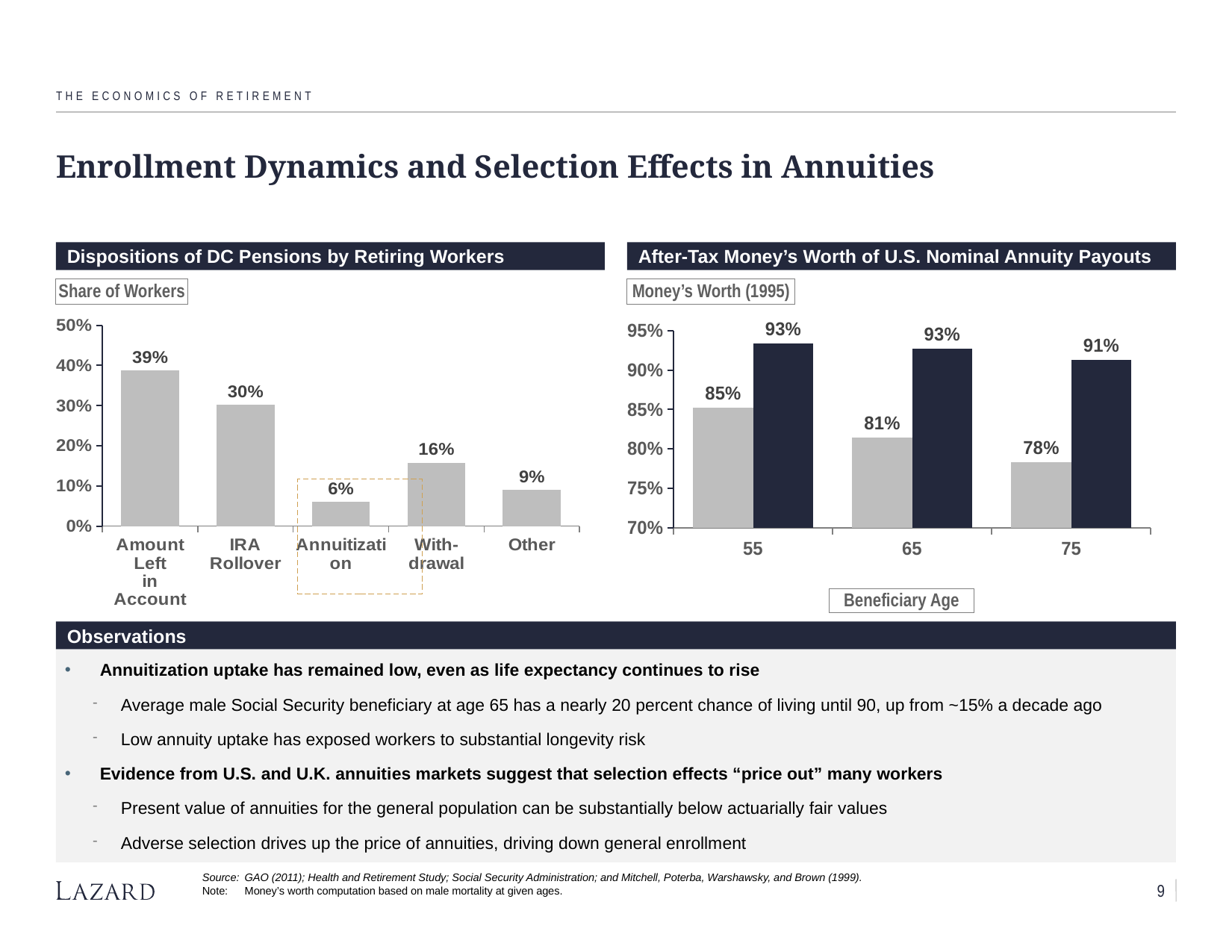
In the 'Dispositions of DC Pensions by Retiring Workers' chart, what share of workers chose Annuitization? 6% In the 'After-Tax Money's Worth of U.S. Nominal Annuity Payouts' chart, what is the value of the dark navy bar at beneficiary age 75? 91% In the 'Dispositions of DC Pensions by Retiring Workers' chart, which category has the lowest share of workers? Annuitization In the 'Dispositions of DC Pensions by Retiring Workers' chart, what share of workers chose IRA Rollover? 30% In the 'After-Tax Money's Worth of U.S. Nominal Annuity Payouts' chart, what is the value of the light grey bar at beneficiary age 65? 81% In the 'Dispositions of DC Pensions by Retiring Workers' chart, which category has the highest share of workers? Amount Left in Account In the 'After-Tax Money's Worth of U.S. Nominal Annuity Payouts' chart, what is the difference between the dark navy bar and the light grey bar at beneficiary age 55? 8% In the 'After-Tax Money's Worth of U.S. Nominal Annuity Payouts' chart, do the light grey bars rise or fall as beneficiary age increases from 55 to 75? Fall In the 'After-Tax Money's Worth of U.S. Nominal Annuity Payouts' chart, what is the label shown below the x axis? Beneficiary Age In the 'Dispositions of DC Pensions by Retiring Workers' chart, how many categories are shown? 5 In the 'Dispositions of DC Pensions by Retiring Workers' chart, what is the difference between the shares for Amount Left in Account and Withdrawal? 23% What type of chart is 'Dispositions of DC Pensions by Retiring Workers'? Bar chart